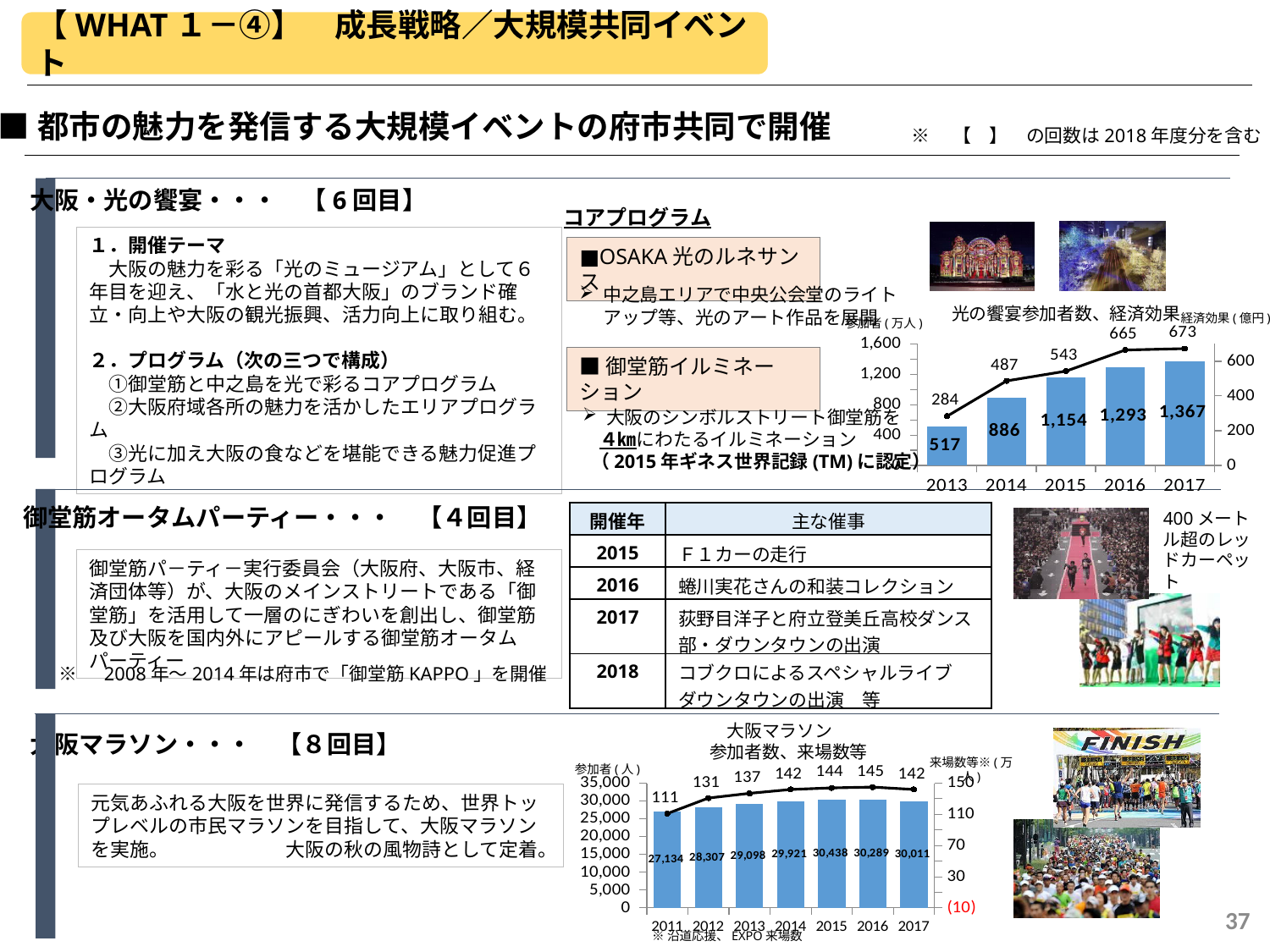
In the 光の饗宴参加者数、経済効果 chart, which year has the lowest bar value? 2013 What kind of chart is the 大阪マラソン 参加者数、来場数等 chart? combined bar and line chart In the 大阪マラソン 参加者数、来場数等 chart, which is larger, the bar value for 2012 or for 2013? 2013 In the 大阪マラソン 参加者数、来場数等 chart, what is the bar value for 2014? 29,921 In the 光の饗宴参加者数、経済効果 chart, what is the 経済効果 line value for 2016? 665 In the 大阪マラソン 参加者数、来場数等 chart, which year has the highest bar value? 2015 In the 光の饗宴参加者数、経済効果 chart, what is the bar value for 2015? 1,154 In the 光の饗宴参加者数、経済効果 chart, how many years are plotted? 5 In the 大阪マラソン 参加者数、来場数等 chart, what is the line value for 2016? 145 In the 光の饗宴参加者数、経済効果 chart, do the bar values rise or fall from 2013 to 2017? rise In the 大阪マラソン 参加者数、来場数等 chart, what is the difference between the line values for 2011 and 2012? 20 In the 光の饗宴参加者数、経済効果 chart, what is the difference between the bar values for 2017 and 2013? 850